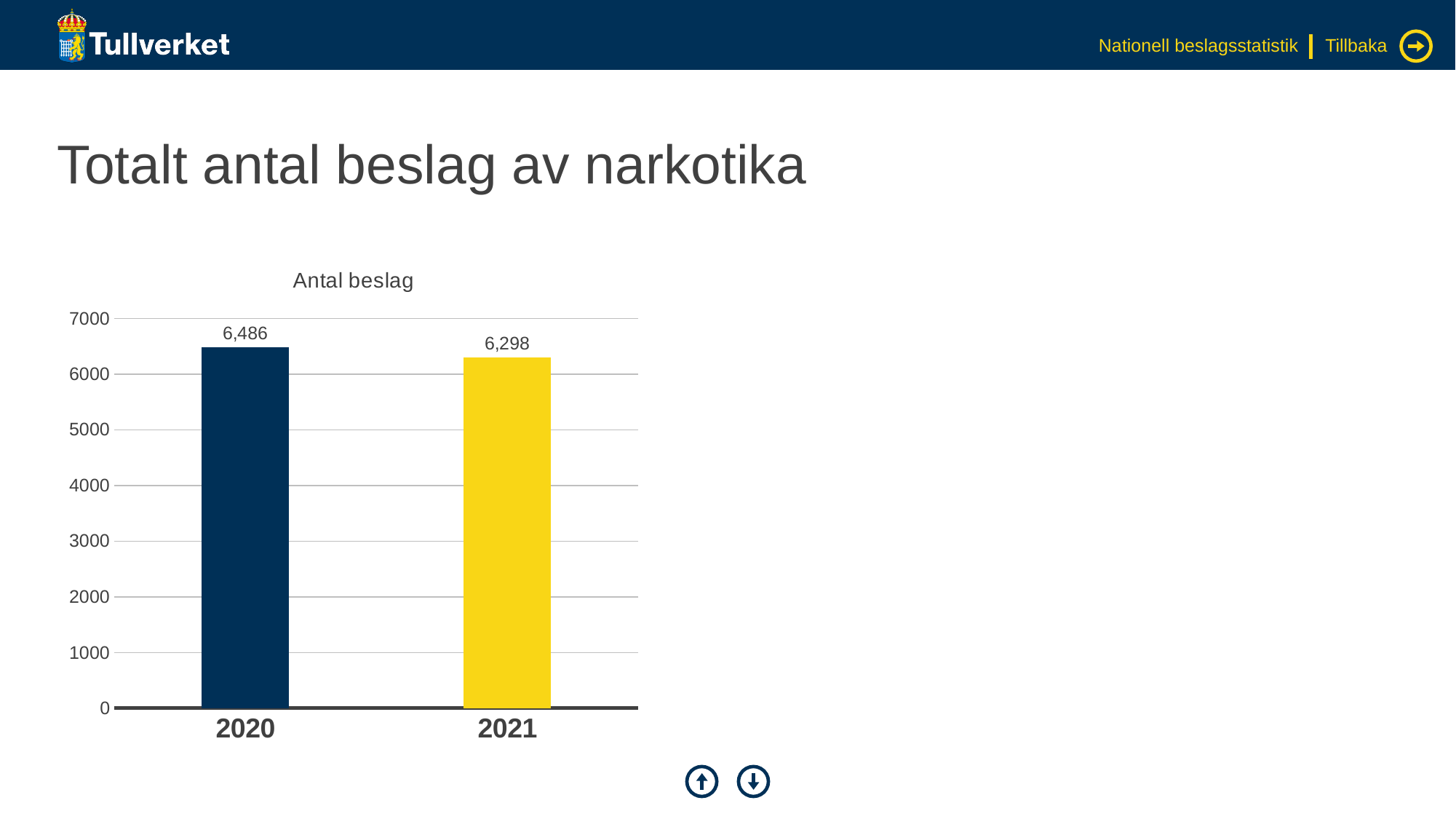
Is the value for 2020 greater or less than 7000? less Do the values rise or fall from 2020 to 2021? fall How many years are shown on the x axis? 2 Which year has the highest number of seizures? 2020 What is the value for 2021? 6,298 Is the value for 2021 greater or less than 6000? greater What is the title of the chart? Antal beslag What kind of chart is shown on the slide? bar chart Which is larger, the value for 2020 or the value for 2021? 2020 What is the value for 2020? 6,486 What is the difference between the values for 2020 and 2021? 188 Which year has the lowest number of seizures? 2021